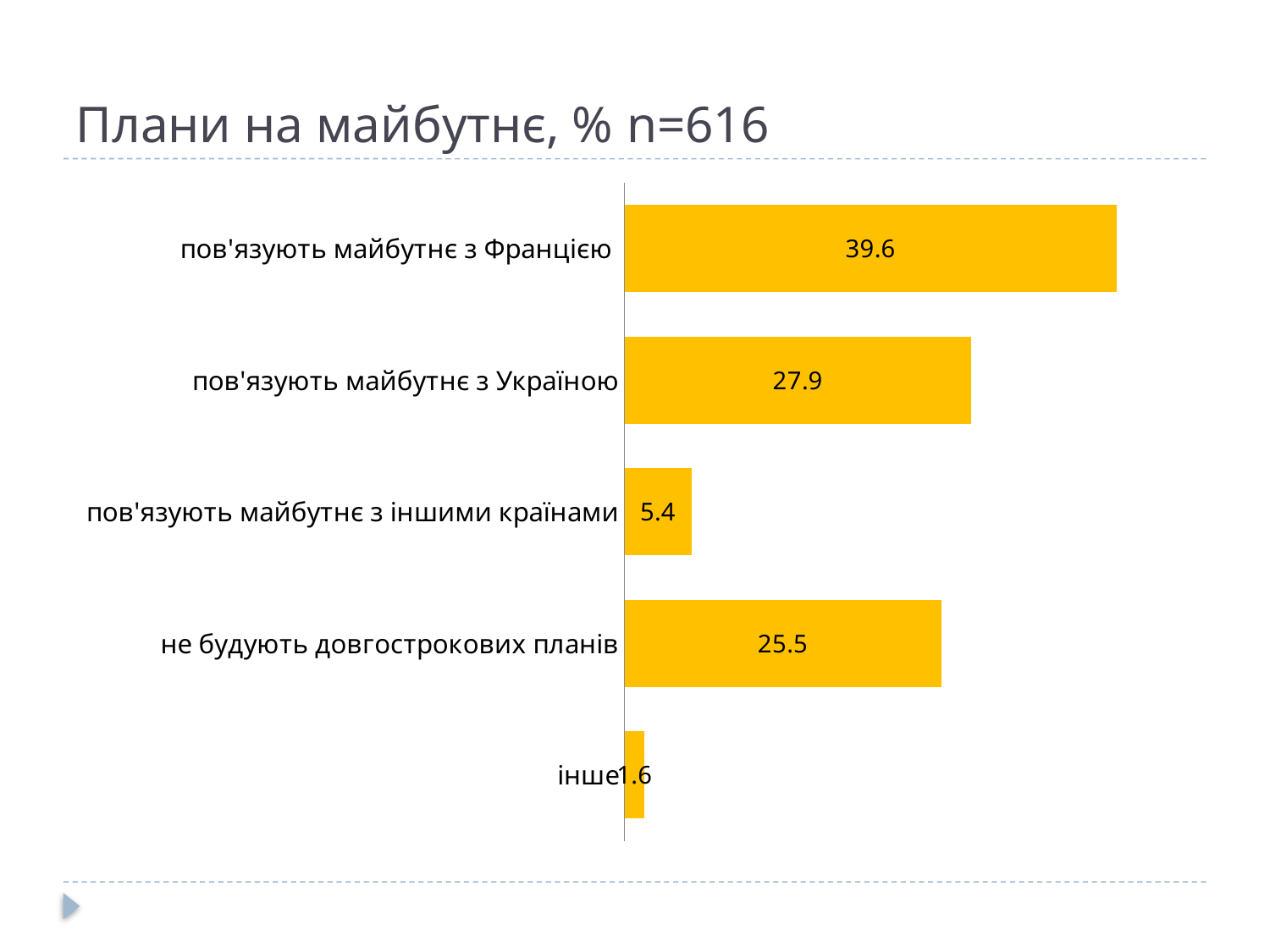
What is the value for "пов'язують майбутнє з Україною"? 27.9 What is the value for "пов'язують майбутнє з Францією"? 39.6 How many categories are shown in the chart? 5 Which category has the lowest value? інше What kind of chart is shown on the slide? bar chart What is the difference between the values for "пов'язують майбутнє з іншими країнами" and "інше"? 3.8 What is the value for "інше"? 1.6 Which category has the highest value? пов'язують майбутнє з Францією What is the value for "не будують довгострокових планів"? 25.5 Which is larger: the value for "пов'язують майбутнє з Україною" or "не будують довгострокових планів"? пов'язують майбутнє з Україною What is the title of the chart? Плани на майбутнє, % n=616 What is the difference between the values for "пов'язують майбутнє з Францією" and "пов'язують майбутнє з Україною"? 11.7